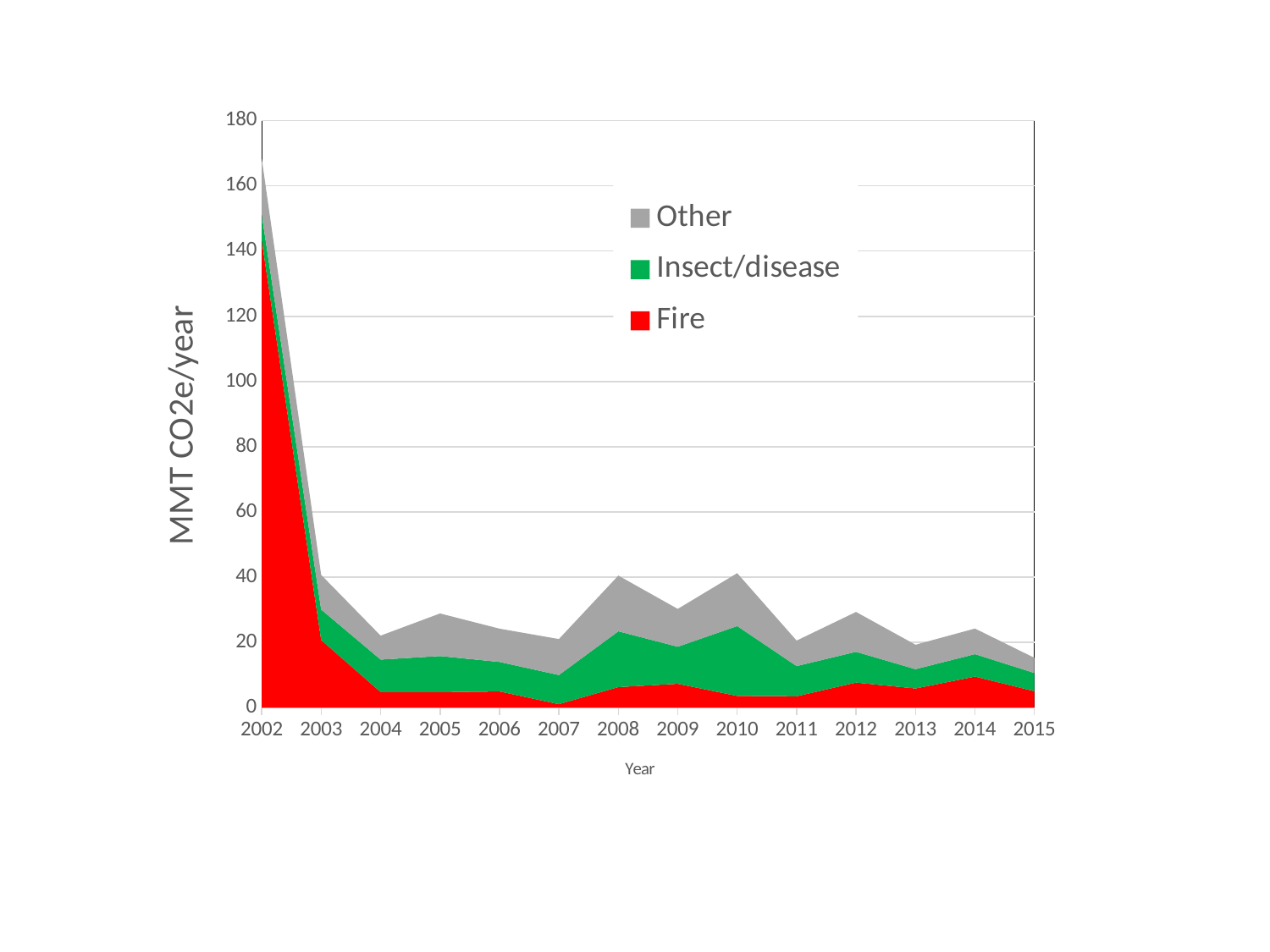
Which year has the larger Fire value, 2002 or 2003? 2002 Is the total stacked value for 2010 greater or less than 20? greater Which series is shown in red? Fire In which year is the Fire value highest? 2002 Does the Fire value rise or fall from 2002 to 2004? Fall In which year is the Fire value lowest? 2007 What is the label on the vertical axis? MMT CO2e/year How many series does the legend list? 3 Is the total stacked value for 2015 greater or less than 20? less Is the Fire value for 2002 greater or less than 100? greater How many years are plotted along the x axis? 14 What kind of chart is shown on the slide? Stacked area chart